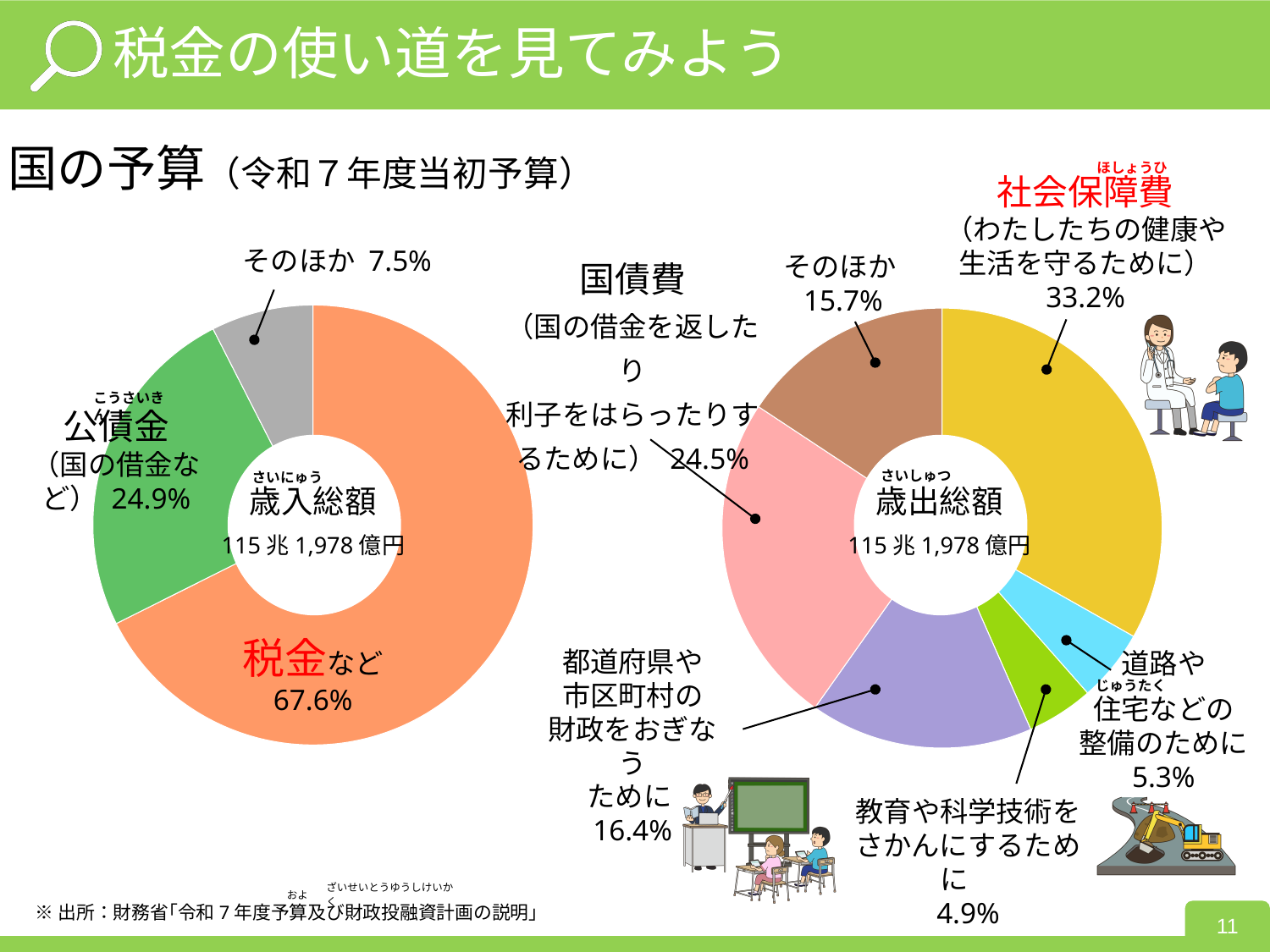
In the right chart (歳出総額), which category has the smallest share? 教育や科学技術をさかんにするために In the right chart (歳出総額), what is the share for 国債費? 24.5% In the right chart (歳出総額), how many categories are shown? 6 In the right chart (歳出総額), what is the share for 社会保障費? 33.2% In the left chart (歳入総額), what is the share for 税金など? 67.6% In the right chart (歳出総額), which is larger: そのほか or 都道府県や市区町村の財政をおぎなうために? 都道府県や市区町村の財政をおぎなうために In the left chart (歳入総額), which category has the smallest share? そのほか In the left chart (歳入総額), how many categories are shown? 3 In the left chart (歳入総額), what is the difference between the shares of 税金など and 公債金? 42.7 percentage points In the right chart (歳出総額), which category has the largest share? 社会保障費 In the left chart (歳入総額), what is the share for 公債金? 24.9% What type of chart is used on this slide? Pie (donut) chart